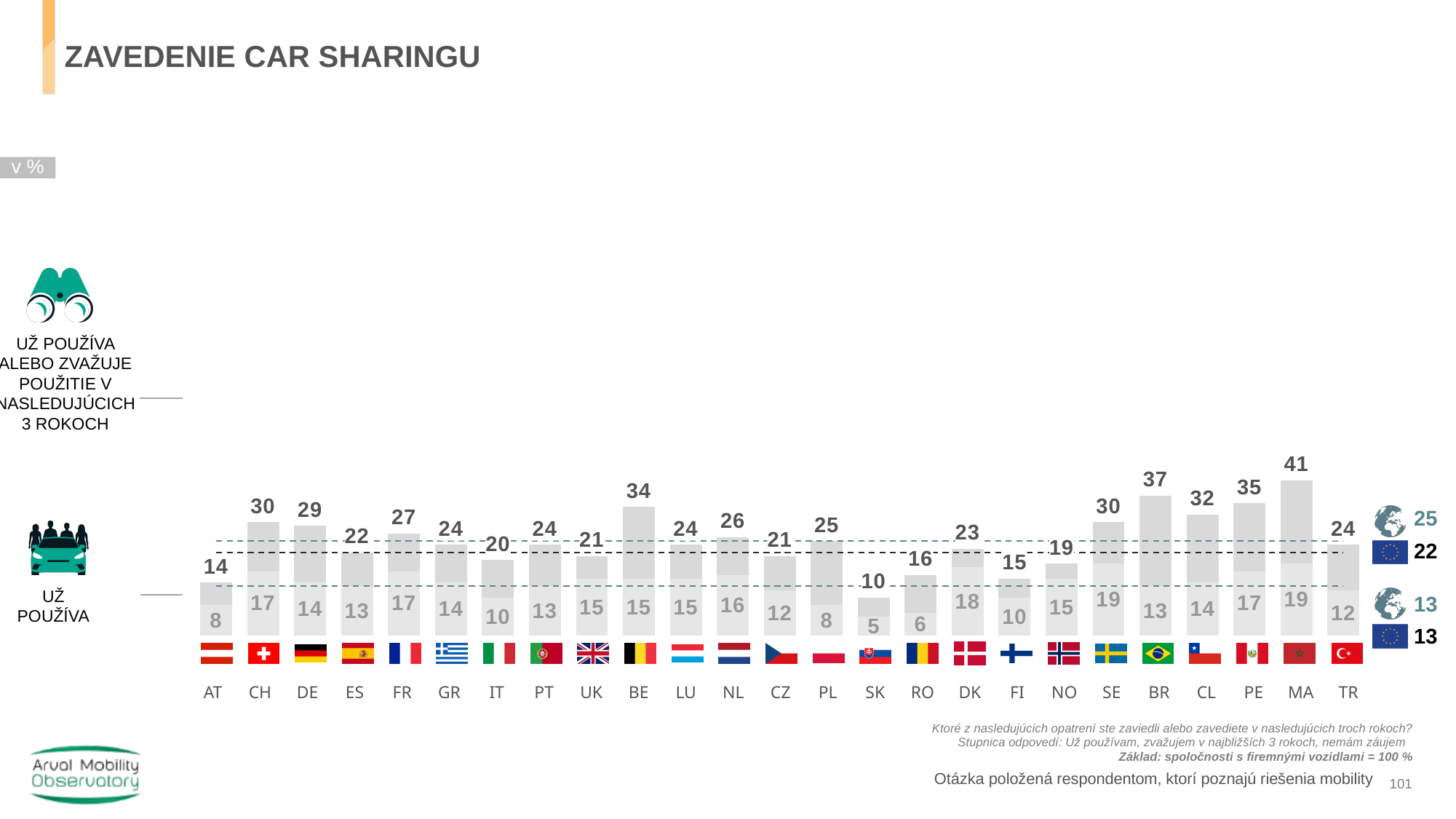
What is the value for MA for 'už používa alebo zvažuje použitie v nasledujúcich 3 rokoch'? 41 Which country has the highest value for 'už používa alebo zvažuje použitie v nasledujúcich 3 rokoch'? MA What is the 'už používa' value for SK? 5 What is the title of the chart on the slide? ZAVEDENIE CAR SHARINGU What is the difference between the 'už používa alebo zvažuje' value for BE and the 'už používa' value for BE? 19 What kind of chart is shown on the slide? bar chart How many countries are shown on the x axis of the chart? 25 What is the 'už používa' value for DK? 18 What is the global average (globe icon) for 'už používa alebo zvažuje použitie v nasledujúcich 3 rokoch'? 25 Which country has the lowest value for 'už používa alebo zvažuje použitie v nasledujúcich 3 rokoch'? SK What is the EU average (EU flag) for 'už používa'? 13 Which is larger: the 'už používa alebo zvažuje' value for BR or for PE? BR